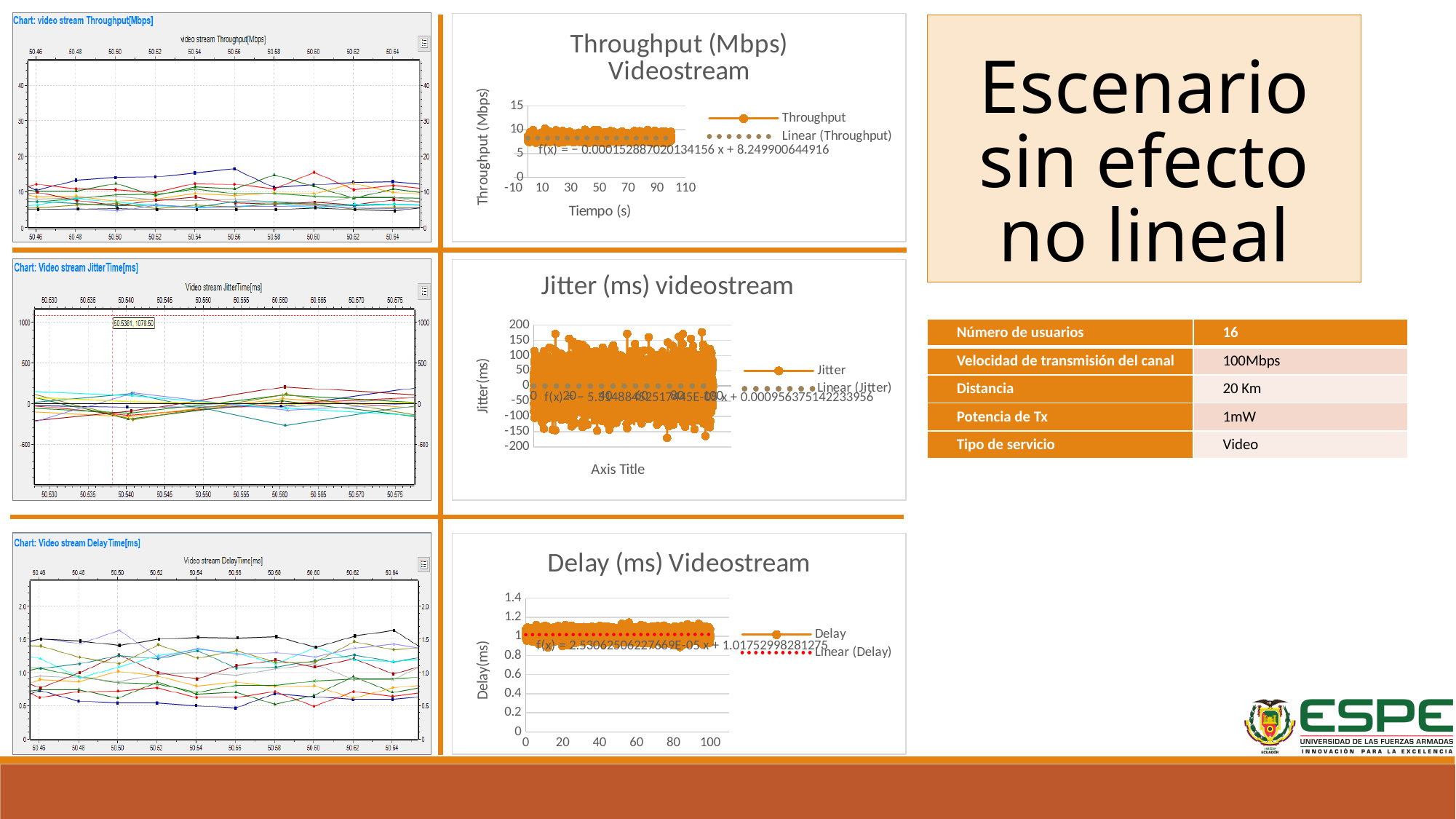
In the 'Delay (ms) Videostream' chart, are the plotted Delay values greater or less than 0.8? greater In the 'Jitter (ms) videostream' chart, what is the highest tick value shown on the vertical axis? 200 In the 'Throughput (Mbps) Videostream' chart, how many series does the legend list? 2 In the 'Throughput (Mbps) Videostream' chart, are the plotted Throughput values greater or less than 5? greater In the 'Throughput (Mbps) Videostream' chart, what is the title of the horizontal axis? Tiempo (s) In the 'Delay (ms) Videostream' chart, how many series does the legend list? 2 What kind of chart is the 'Delay (ms) Videostream' chart? scatter chart In the 'Jitter (ms) videostream' chart, how many series does the legend list? 2 In the 'Delay (ms) Videostream' chart, are the plotted Delay values greater or less than 1.2? less